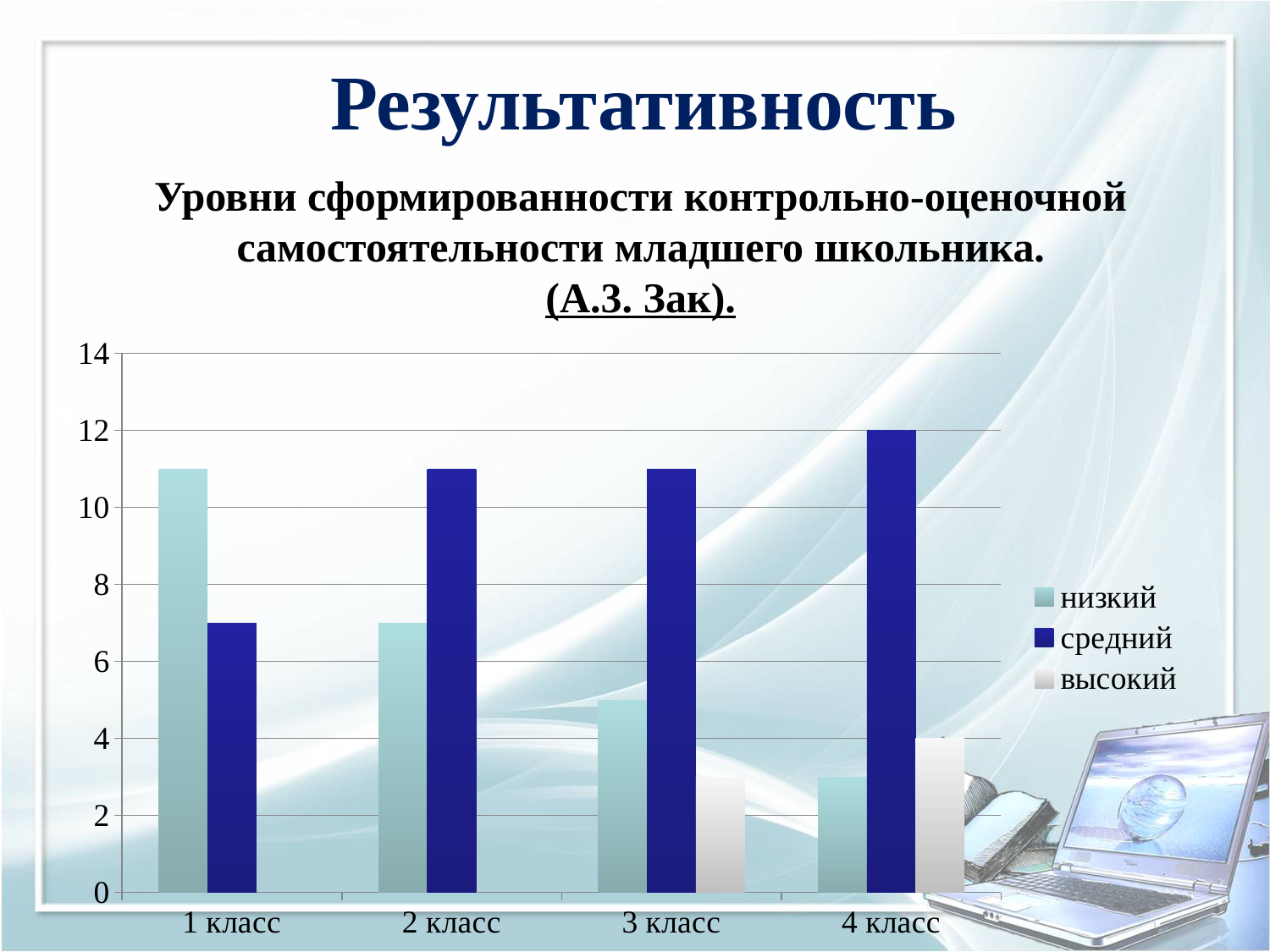
Is the value of средний for 1 класс greater or less than 8? less Which is larger for 2 класс: низкий or средний? средний Which category has the lowest value for низкий? 4 класс How many series does the legend list? 3 How many categories are shown on the x axis? 4 Is the value of низкий for 1 класс greater or less than 10? greater What kind of chart is shown on the slide? bar chart Is the value of низкий for 4 класс greater or less than 4? less Does the value of низкий rise or fall from 1 класс to 4 класс? fall What is the value of средний for 4 класс? 12 Which category has the highest value for средний? 4 класс What is the value of высокий for 4 класс? 4